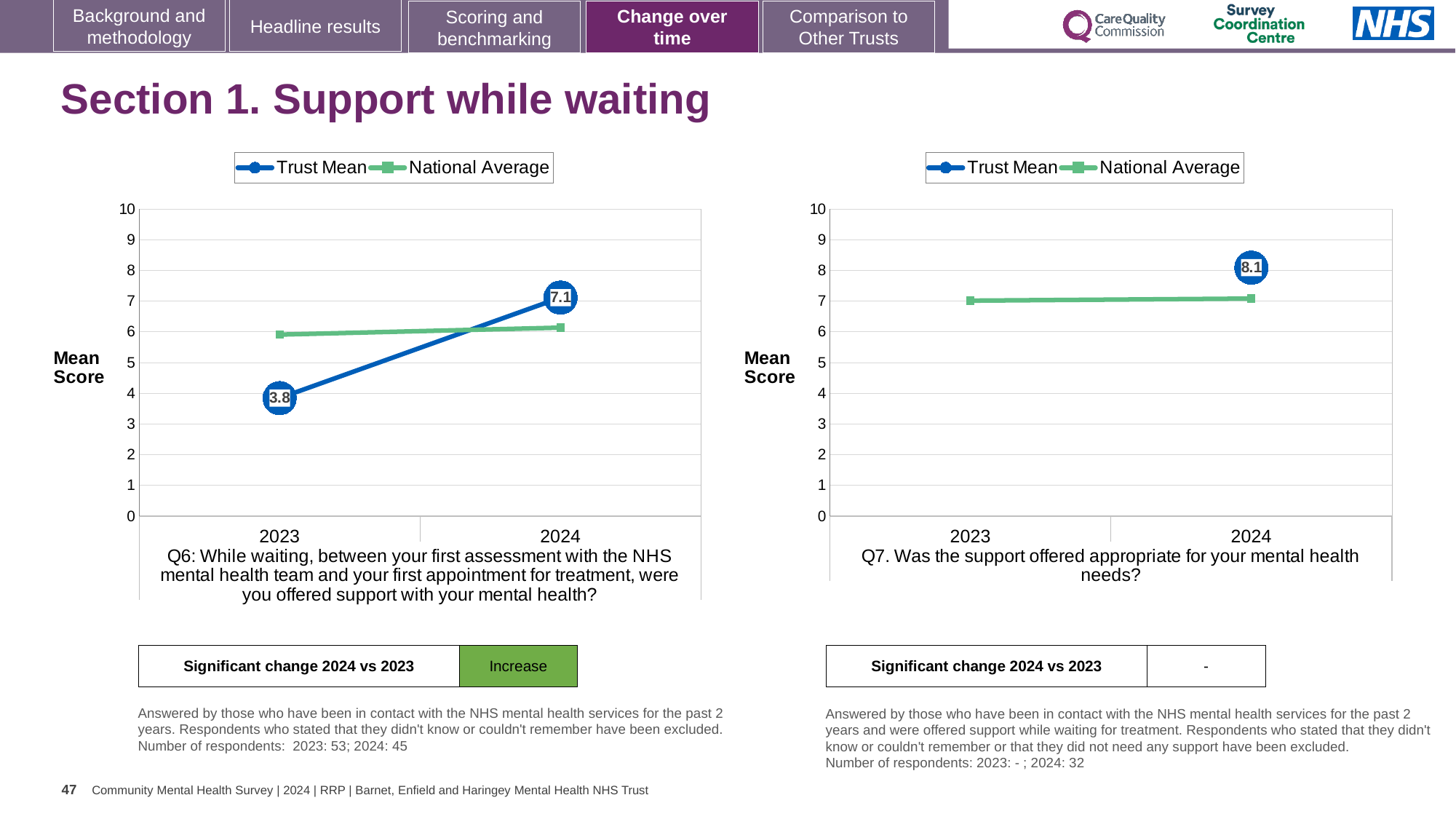
In the Q7 chart on the right, is the National Average for 2023 greater or less than 8? less How many years are shown on the x axis of the Q6 chart on the left? 2 In the Q6 chart on the left, by how much did the Trust Mean change from 2023 to 2024? 3.3 In the Q6 chart on the left, is the Trust Mean for 2024 greater or less than the National Average for 2024? greater In the Q7 chart on the right, is the Trust Mean for 2024 greater or less than the National Average for 2024? greater In the Q6 chart on the left, what is the Trust Mean for 2023? 3.8 What kind of chart is the Q7 chart on the right? line chart In the Q6 chart on the left, is the Trust Mean for 2023 greater or less than the National Average for 2023? less In the Q6 chart on the left, does the Trust Mean rise or fall from 2023 to 2024? rise How many series does the legend of the Q6 chart on the left list? 2 In the Q6 chart on the left, what is the Trust Mean for 2024? 7.1 In the Q7 chart on the right, what is the Trust Mean for 2024? 8.1